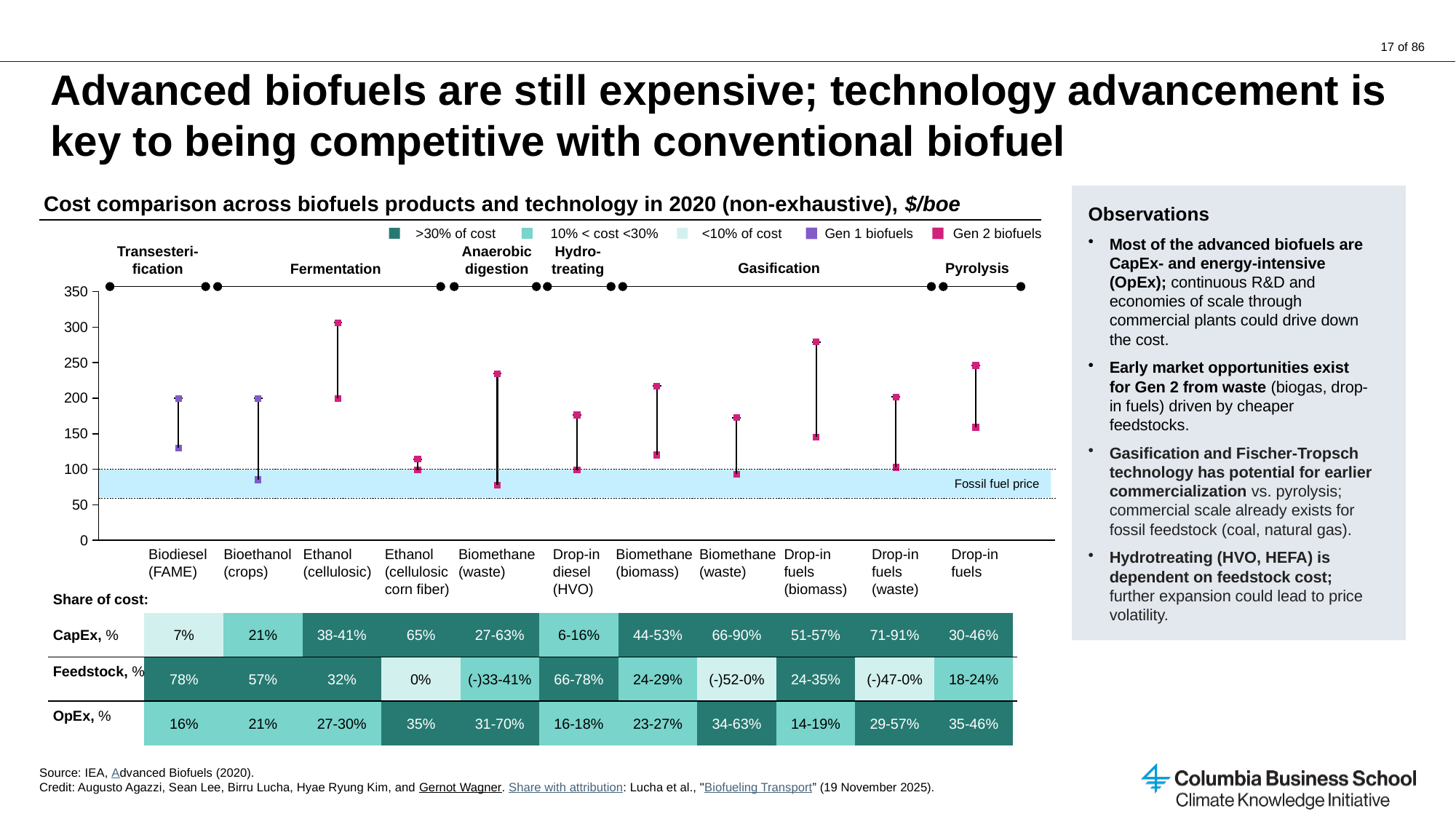
In the Share of cost table, what is the Feedstock share for Ethanol (cellulosic corn fiber)? 0% Which biofuel product has the highest upper cost estimate in the chart? Ethanol (cellulosic) How many biofuel products are plotted along the x axis of the cost comparison chart? 11 What is the label of the shaded horizontal band near 60-100 $/boe on the chart? Fossil fuel price Which two biofuel products are marked as Gen 1 biofuels in the chart? Biodiesel (FAME) and Bioethanol (crops) Is the lower end of the cost range for Biodiesel (FAME) greater or less than 100 $/boe? greater Is the upper end of the cost range for Ethanol (cellulosic corn fiber) greater or less than 150 $/boe? less Is the upper end of the cost range for Drop-in fuels (biomass) greater or less than 250 $/boe? greater In the Share of cost table, what is the CapEx share for Biodiesel (FAME)? 7% Which has a higher upper cost estimate: Ethanol (cellulosic) or Drop-in diesel (HVO)? Ethanol (cellulosic) How many entries does the legend of the cost comparison chart list? 5